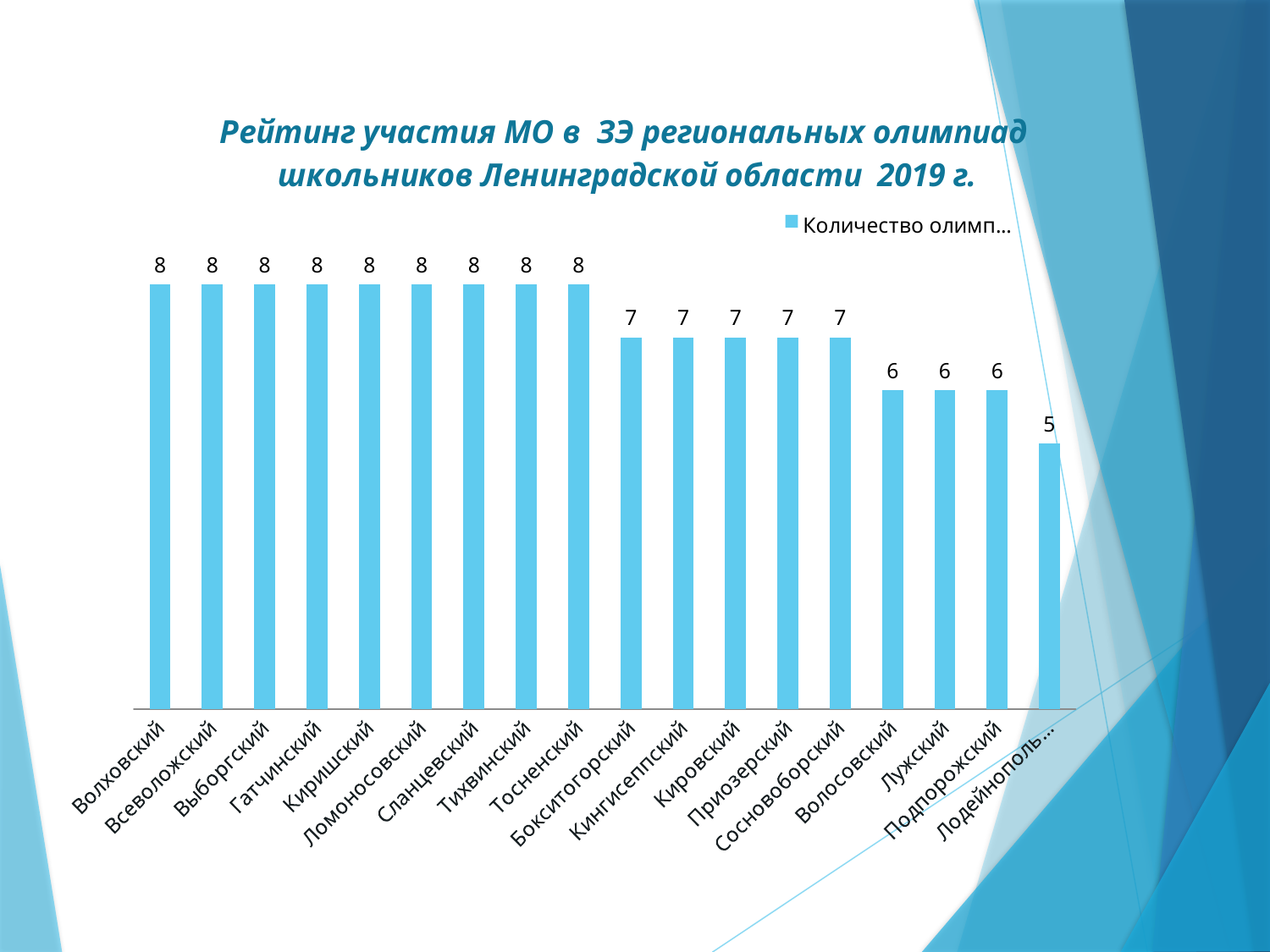
What is the highest value shown on the chart? 8 What is the lowest value shown on the chart? 5 What kind of chart is shown on the slide? bar chart How many categories are shown on the chart? 18 What is the value for Сосновоборский? 7 What is the difference between the values for Гатчинский and Волосовский? 2 What is the value for Бокситогорский? 7 What is the value for Тосненский? 8 What is the value for Волховский? 8 Do the values rise or fall from left to right along the x axis? fall What is the value for Лужский? 6 Which has a larger value, Кировский or Подпорожский? Кировский